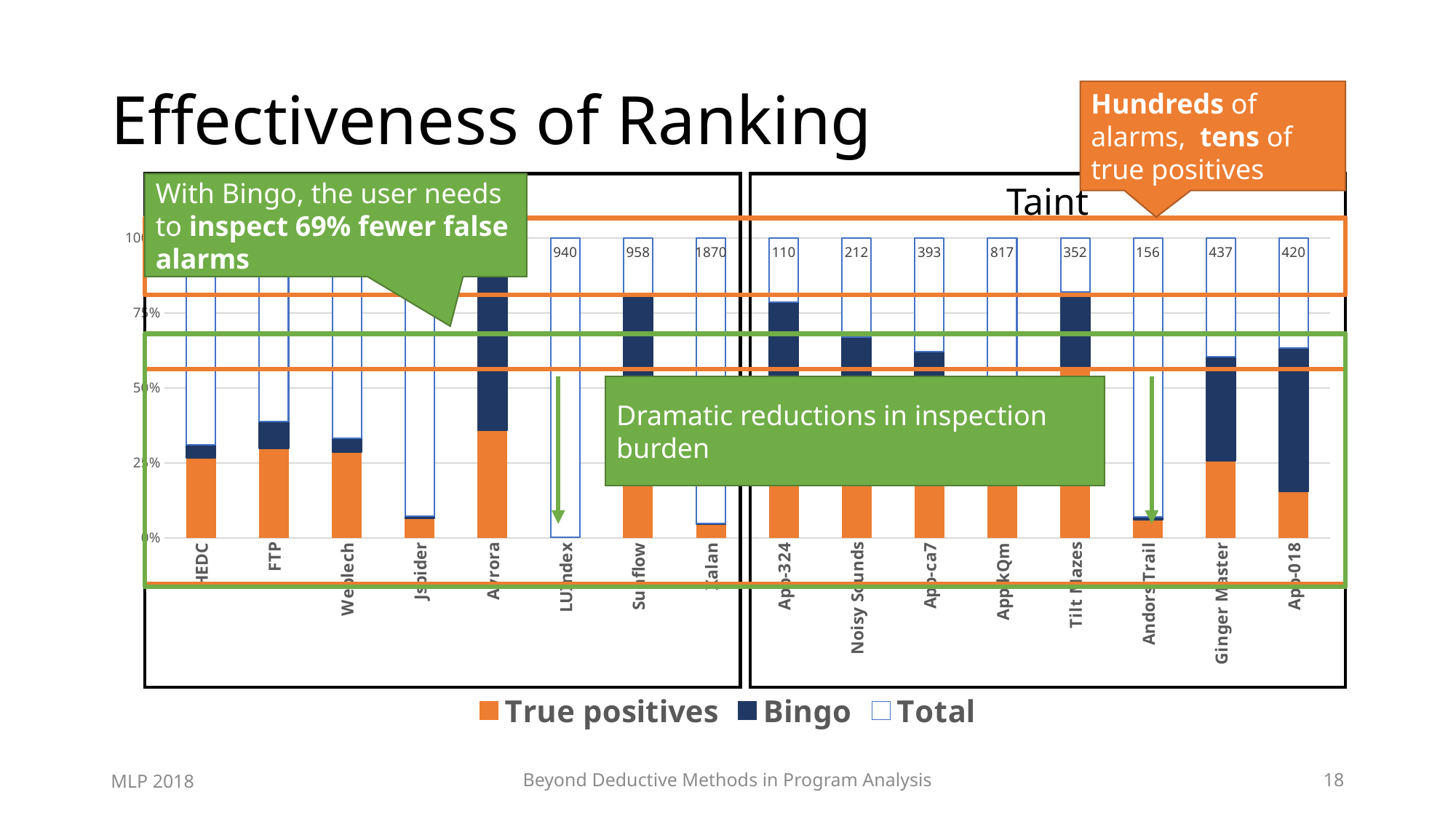
What is the Total value printed above the App-324 bar? 110 Is the top of the Bingo bar for App-324 greater or less than 75%? greater What is the Total value printed above the AppKQm bar? 817 What is the difference between the printed Total values for Sunflow and LUindex? 18 Among the printed Total values, which category has the lowest total? App-324 How many series does the legend list? 3 Among the printed Total values, which category has the highest total? Xalan Is the top of the Bingo bar for Jspider greater or less than 25%? less Which has a larger printed Total value, Ginger Master or App-018? Ginger Master What is the Total value printed above the Xalan bar? 1870 What is the Total value printed above the Andors Trail bar? 156 What kind of chart is shown on the slide? Bar chart